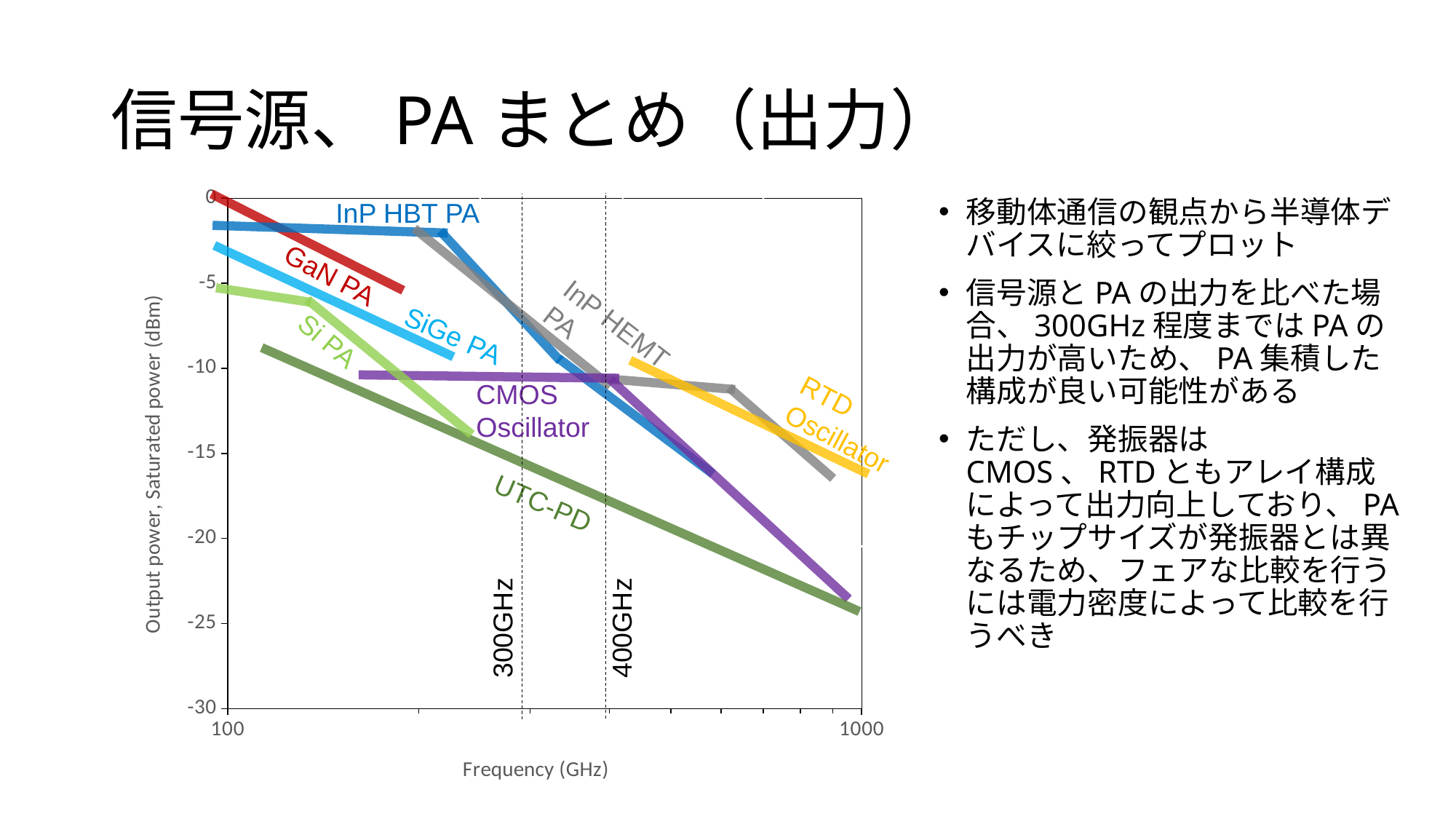
Is the output power of the SiGe PA line at 100 GHz greater or less than -5 dBm? greater Does the output power of the UTC-PD line rise or fall as frequency increases? Fall Is the output power of the UTC-PD line at 1000 GHz greater or less than -20 dBm? less Is the output power of the InP HBT PA line at 100 GHz greater or less than -5 dBm? greater At 300 GHz, which line shows higher output power: InP HEMT PA or CMOS Oscillator? InP HEMT PA What kind of chart is shown on the slide? Line chart What is the label of the x axis of the chart? Frequency (GHz) What is the label of the y axis of the chart? Output power, Saturated power (dBm) How many labeled series (lines) are plotted on the chart? 8 At 1000 GHz, which line shows higher output power: RTD Oscillator or UTC-PD? RTD Oscillator